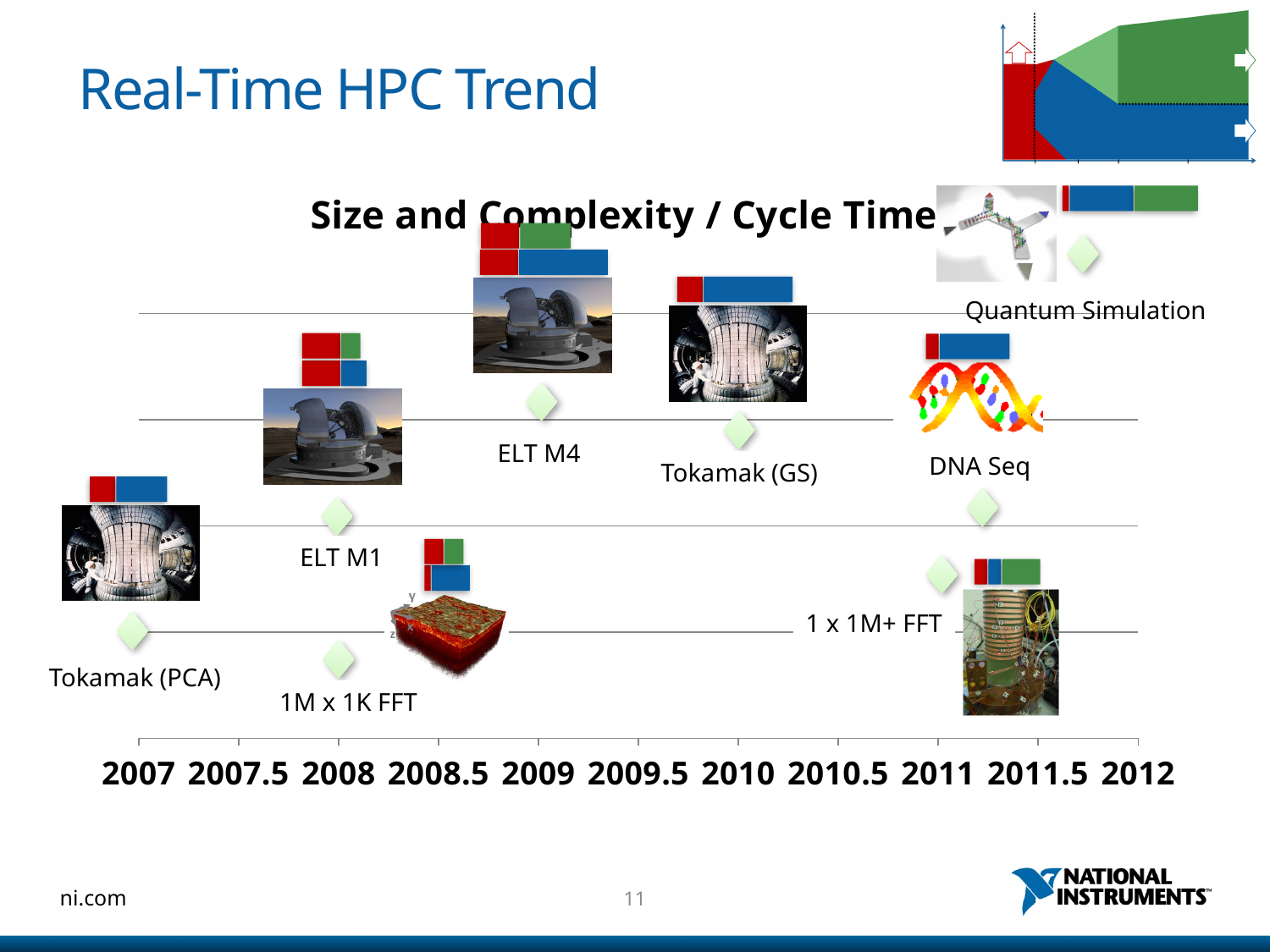
Which data point is plotted highest on the chart? Quantum Simulation Which is plotted higher on the chart, ELT M1 or 1M x 1K FFT? ELT M1 Which is plotted higher on the chart, Tokamak (GS) or Tokamak (PCA)? Tokamak (GS) What is the title of the chart? Size and Complexity / Cycle Time Do the plotted points generally rise or fall as the years increase along the x axis? rise How many labeled data points are plotted on the chart? 8 Is the x-axis position of ELT M4 greater or less than 2008.5? greater Is the x-axis position of Tokamak (GS) greater or less than 2009.5? greater What is the last year label on the x axis? 2012 Which data point is plotted earliest on the x axis? Tokamak (PCA) What is the first year label on the x axis? 2007 What kind of chart is shown on the slide? scatter chart